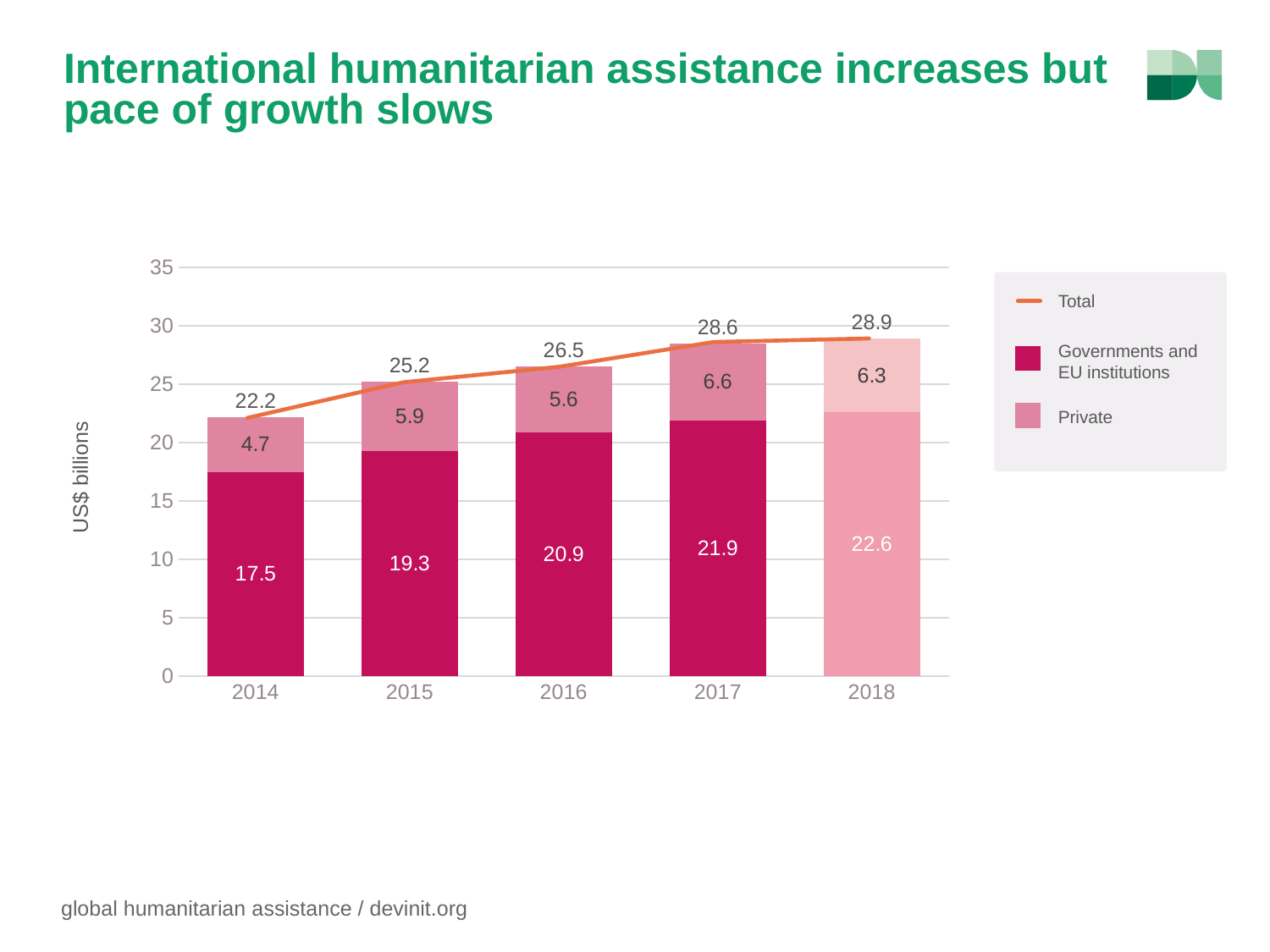
Does the Total rise or fall from 2014 to 2018? Rise How many years are shown on the x axis? 5 How many entries does the legend list? 3 What is the difference between the Total in 2018 and the Total in 2014? 6.7 Which year had the lowest Private value? 2014 Which is larger: the Private value in 2017 or the Private value in 2018? 2017 What unit is shown on the y axis? US$ billions Which year had the highest Total? 2018 What was the value for Governments and EU institutions in 2016? 20.9 What was the Private value in 2017? 6.6 What was the Total in 2015? 25.2 What kind of chart is shown on the slide? Stacked bar chart with a line